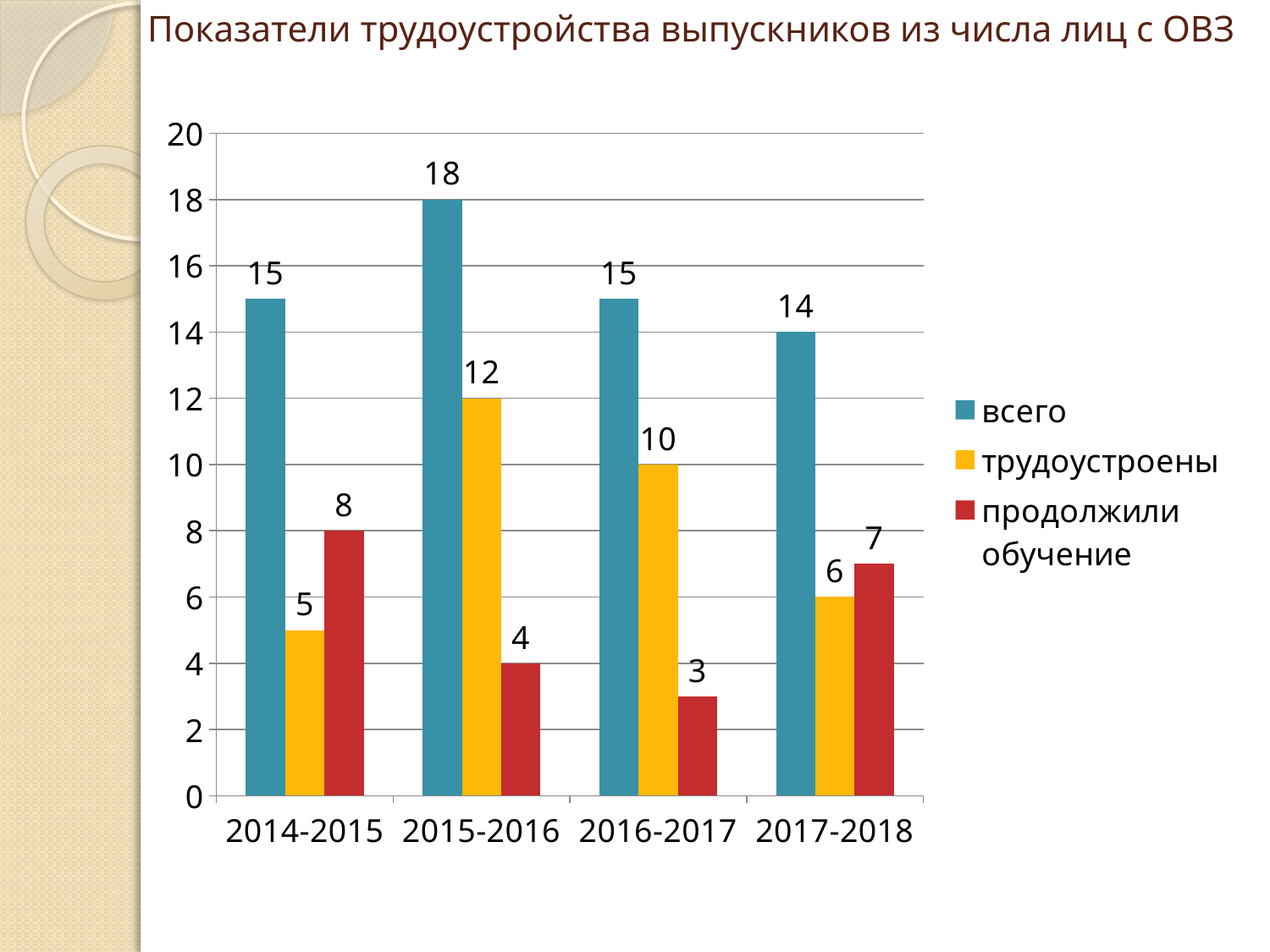
What kind of chart is shown on the slide? bar chart What is the value of "продолжили обучение" for 2014-2015? 8 In which period is the "продолжили обучение" value lowest? 2016-2017 Does the "трудоустроены" value rise or fall from 2015-2016 to 2017-2018? fall Which is larger in 2014-2015: "трудоустроены" or "продолжили обучение"? продолжили обучение What is the value of "трудоустроены" for 2017-2018? 6 What colour represents the "всего" series? blue How many periods are shown on the x axis? 4 What is the value of "всего" for 2015-2016? 18 In which period is the "всего" value highest? 2015-2016 How many series does the legend list? 3 What is the difference between "всего" and "трудоустроены" in 2016-2017? 5